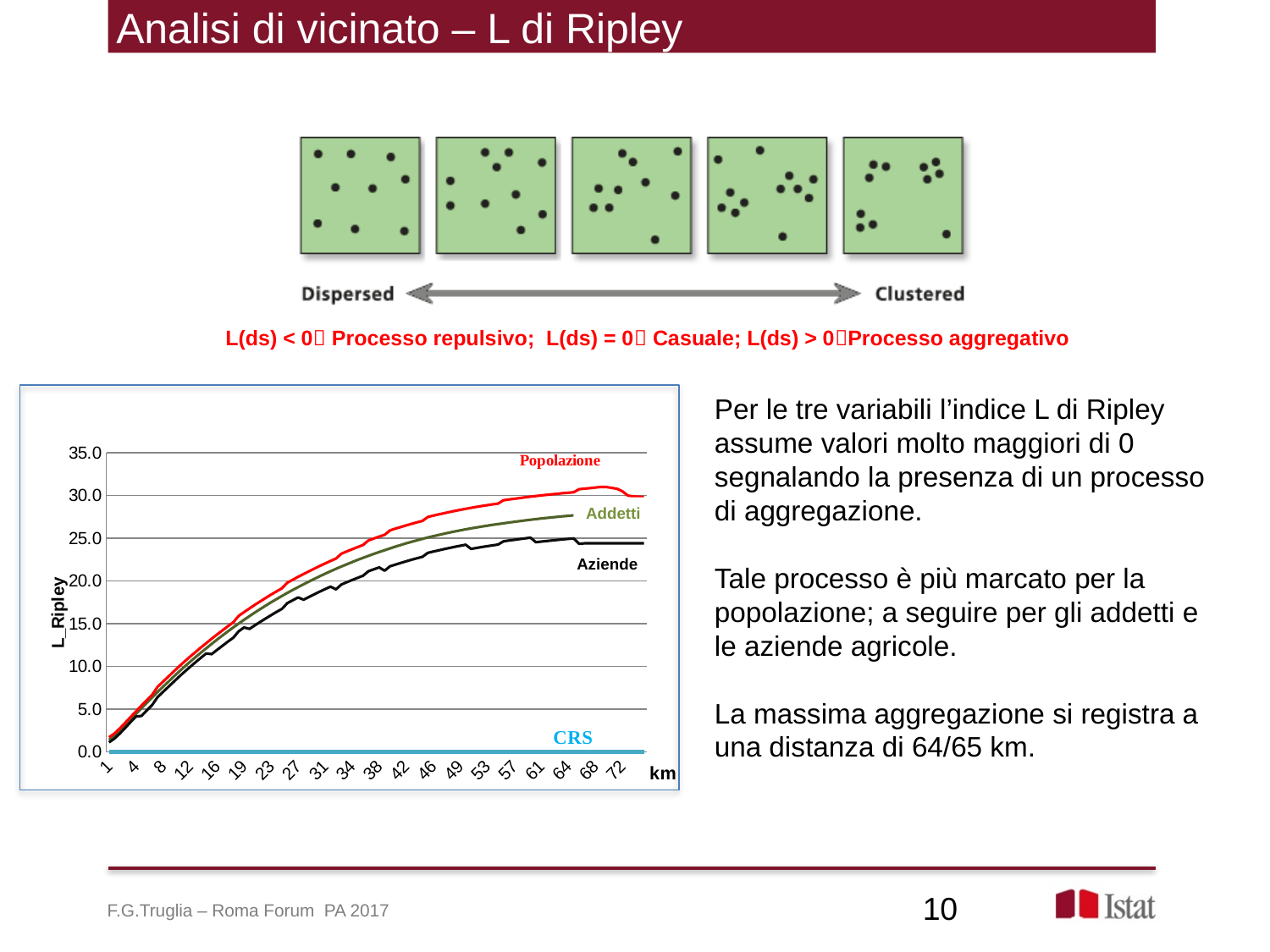
What is the label of the vertical axis of the chart? L_Ripley At 46 km, which is larger: Popolazione or Aziende? Popolazione Does the Popolazione line rise or fall as km increases from 1 to 46? rise Which series has the lowest values across all distances in the chart? CRS Is the value of Aziende at 16 km greater or less than 10.0? greater How many series are plotted in the chart? 4 Which series reaches the highest L_Ripley value in the chart? Popolazione Is the value of Popolazione at 46 km greater or less than 25.0? greater What colour is the Popolazione line in the chart? red What kind of chart is shown on the slide? line chart Is the value of Addetti at 64 km greater or less than 25.0? greater